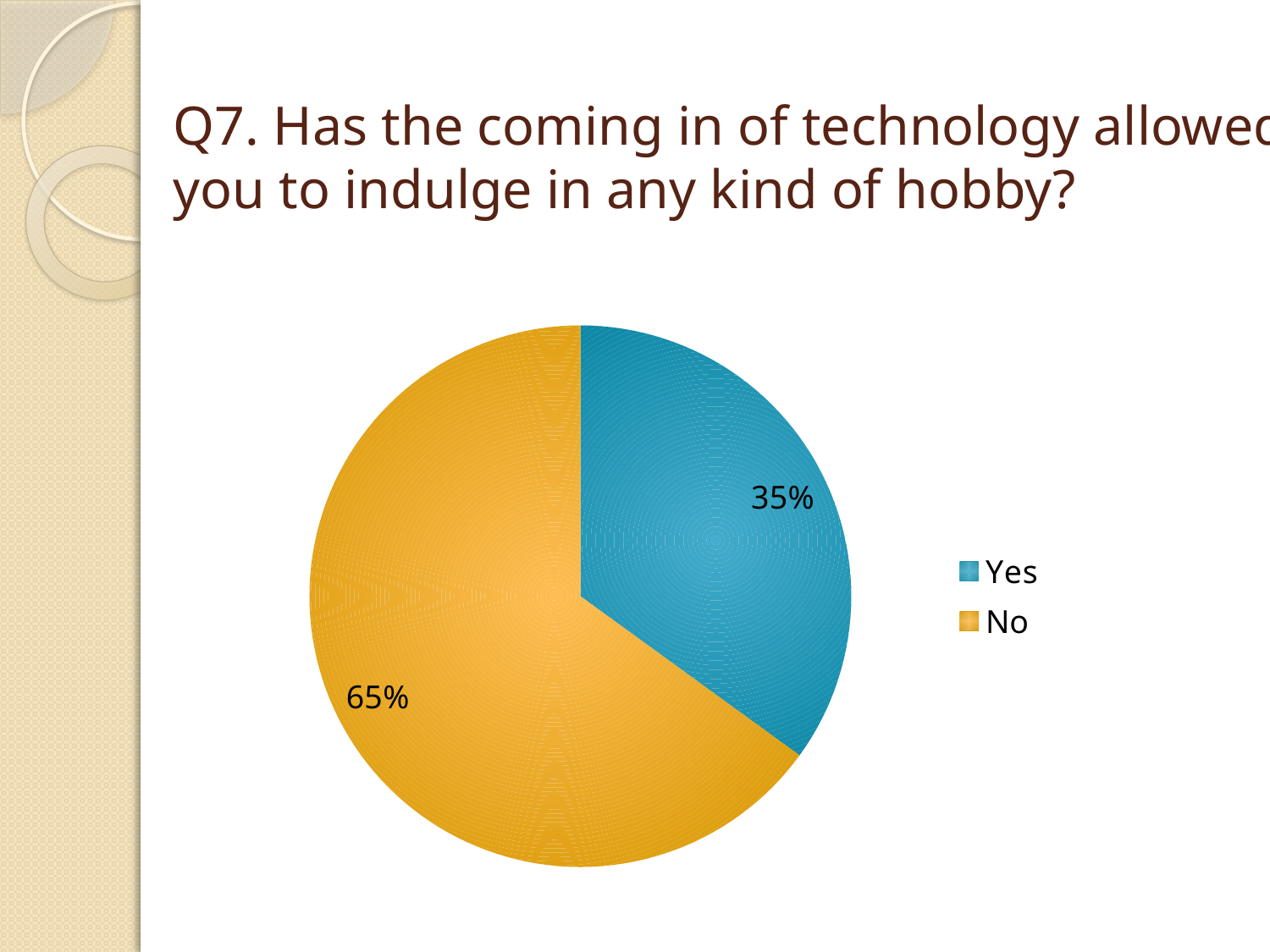
What colour is the Yes slice? blue Which slice is larger, Yes or No? No Which response has the smallest share of the pie? Yes What kind of chart is shown on the slide? pie chart What share of the pie does the Yes slice represent? 35% What percentage of respondents answered Yes? 35% What colour is the No slice? orange Which response has the largest share of the pie? No How many entries does the legend list? 2 What percentage of respondents answered No? 65% How many slices does the pie chart have? 2 What is the difference in percentage points between the No and Yes slices? 30